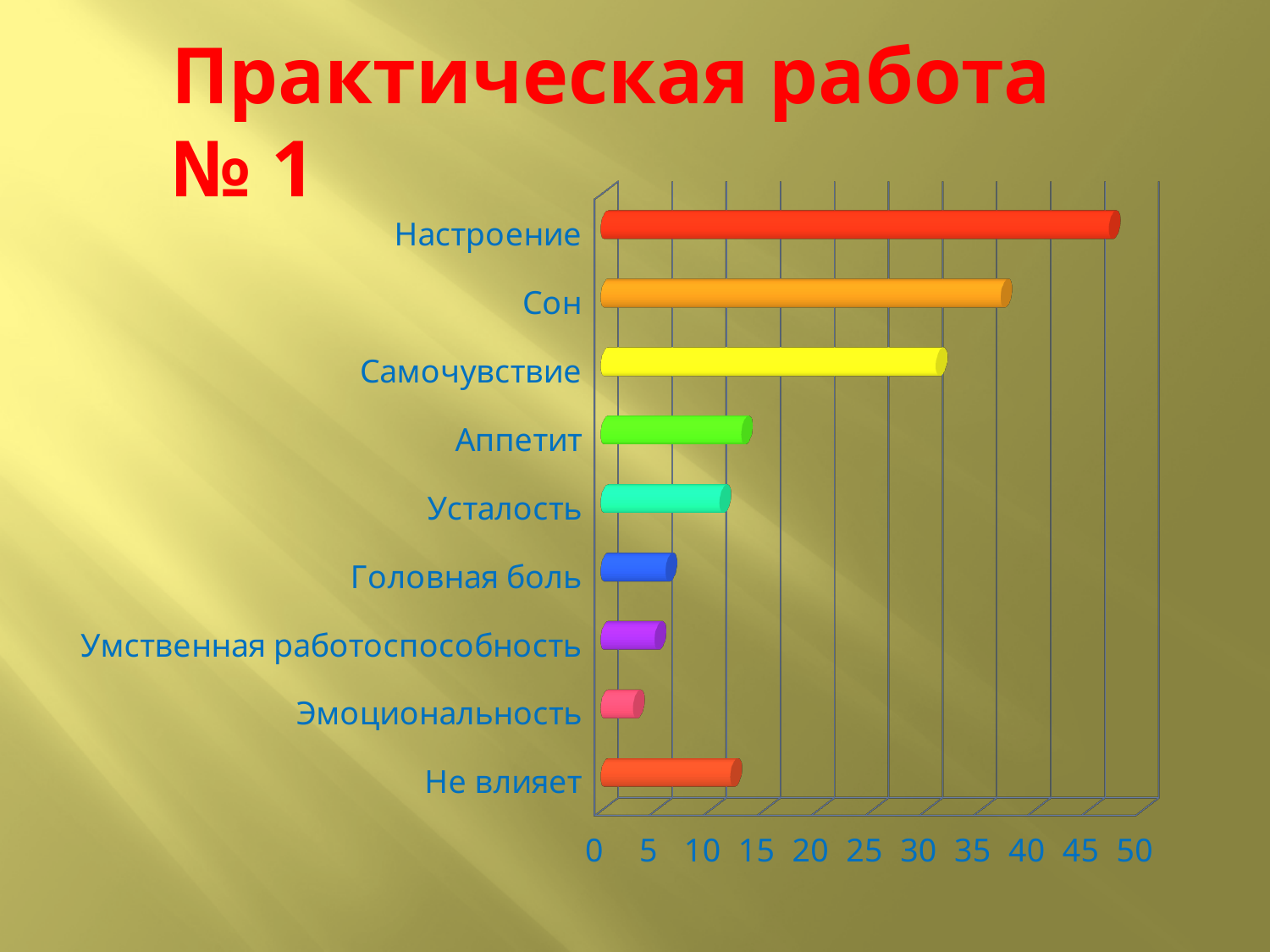
Which category has the highest value in the chart? Настроение Is the value for Эмоциональность greater or less than 5? less Is the value for Головная боль greater or less than 10? less Is the value for Сон greater or less than 35? greater Which is larger, the value for Сон or the value for Самочувствие? Сон Which category has the lowest value in the chart? Эмоциональность What is the title shown above the chart on the slide? Практическая работа № 1 What kind of chart is shown on the slide? Bar chart How many categories are plotted in the chart? 9 Which is larger, the value for Аппетит or the value for Головная боль? Аппетит